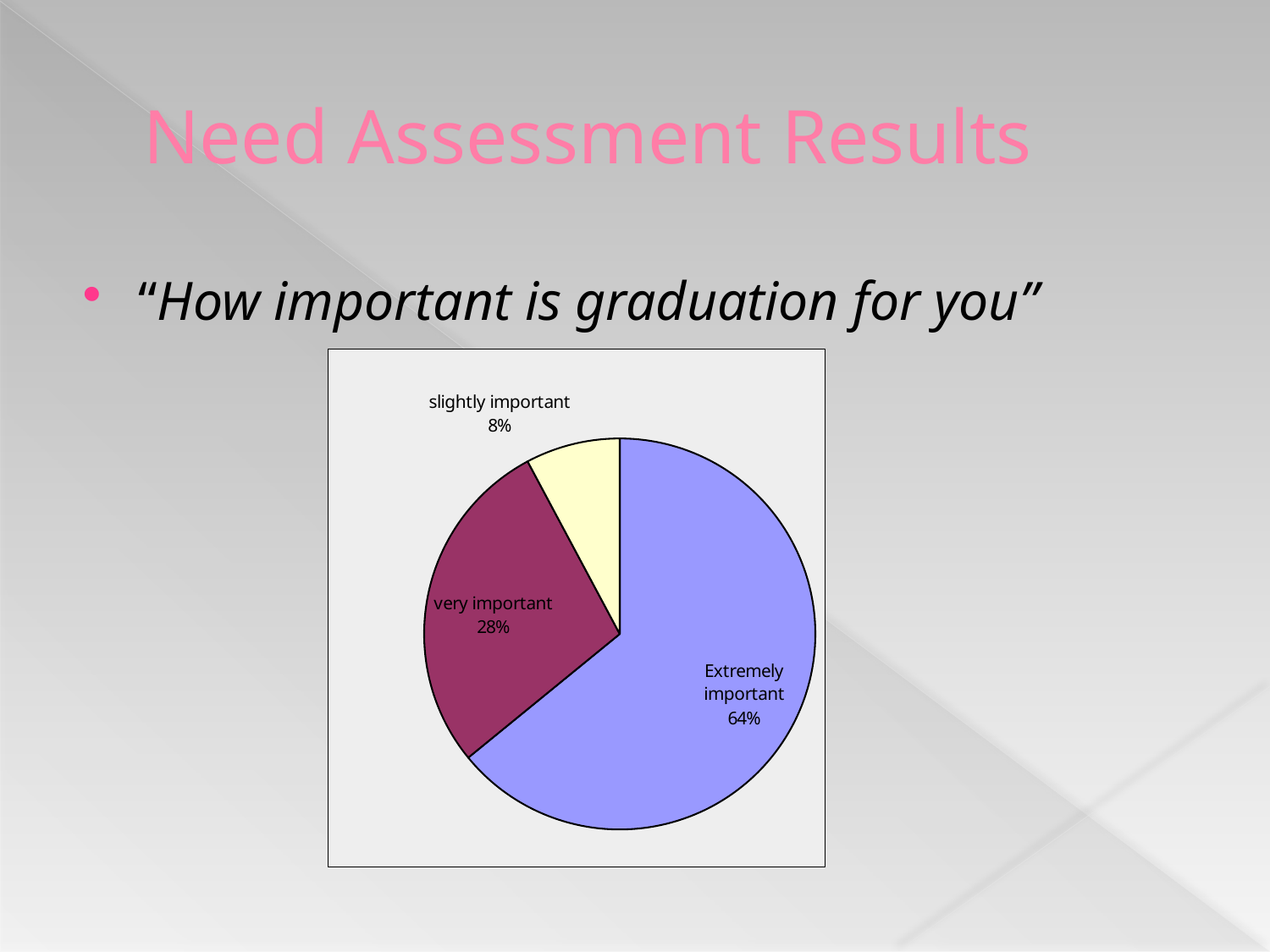
How many slices does the pie chart have? 3 What percentage of respondents said graduation is very important? 28% Which slice is larger: 'very important' or 'slightly important'? very important What kind of chart is shown on the slide? pie chart What is the difference in percentage points between the 'Extremely important' and 'very important' slices? 36 Which response category has the largest share of the pie? Extremely important What is the difference in percentage points between the 'very important' and 'slightly important' slices? 20 What colour is the 'Extremely important' slice? light blue/purple What survey question does the pie chart present results for? How important is graduation for you What percentage of respondents said graduation is extremely important? 64% What percentage of respondents said graduation is slightly important? 8% Which response category has the smallest share of the pie? slightly important